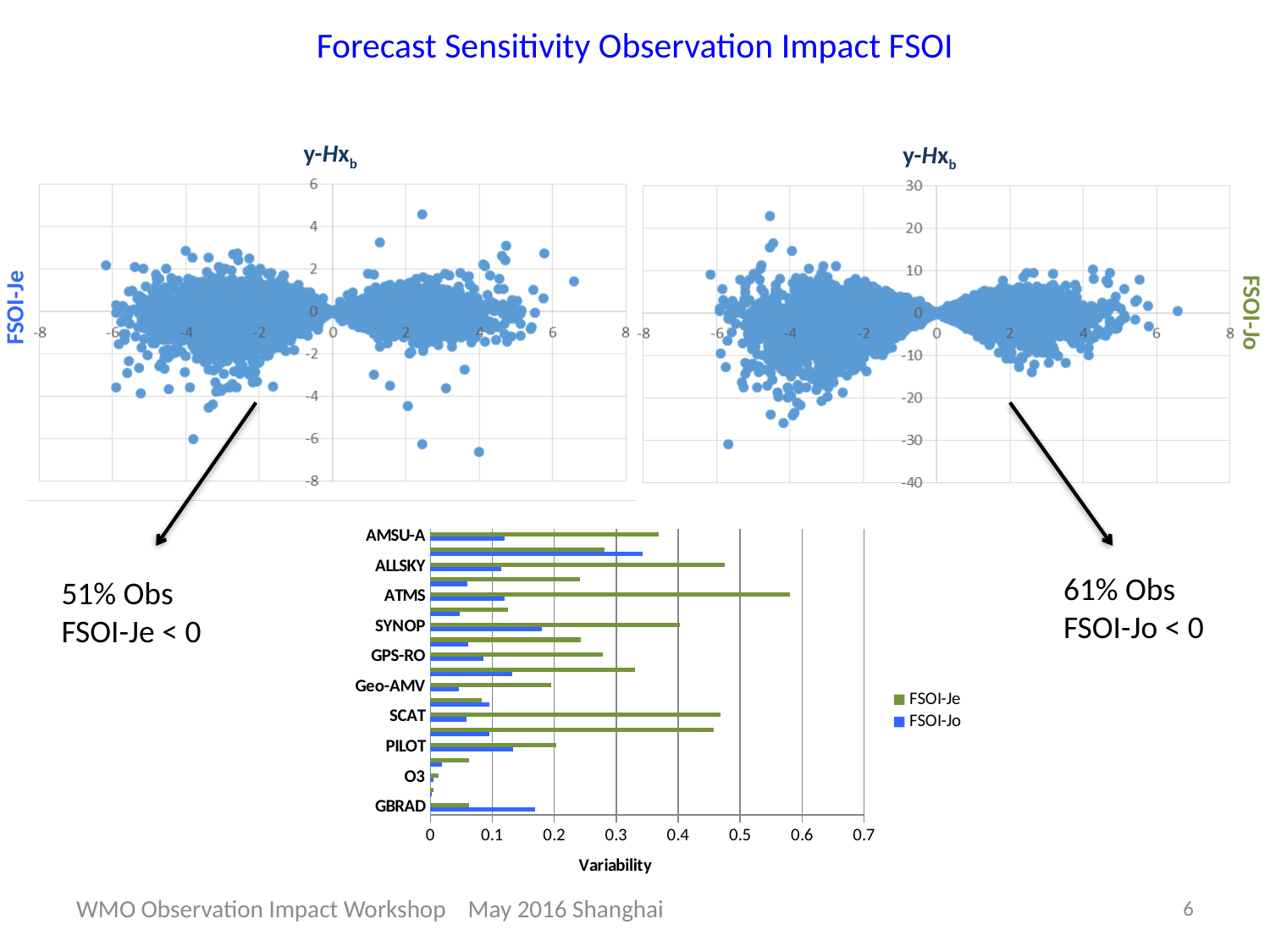
In the bottom Variability bar chart, is the FSOI-Je value for ATMS greater or less than 0.5? greater In the bottom Variability bar chart, is the FSOI-Je value for SCAT greater or less than 0.4? greater In the bottom Variability bar chart, how many series does the legend list? 2 What kind of chart is the bottom chart with the x-axis labelled Variability? bar chart In the bottom Variability bar chart, which is larger for ATMS, the FSOI-Je value or the FSOI-Jo value? FSOI-Je In the bottom Variability bar chart, is the FSOI-Je value for AMSU-A greater or less than 0.3? greater In the bottom Variability bar chart, which is larger for GBRAD, the FSOI-Je value or the FSOI-Jo value? FSOI-Jo In the bottom Variability bar chart, which category has the highest FSOI-Je value? ATMS What kind of chart is the top-left chart labelled FSOI-Je? scatter plot In the bottom Variability bar chart, which colour represents the FSOI-Jo series? blue